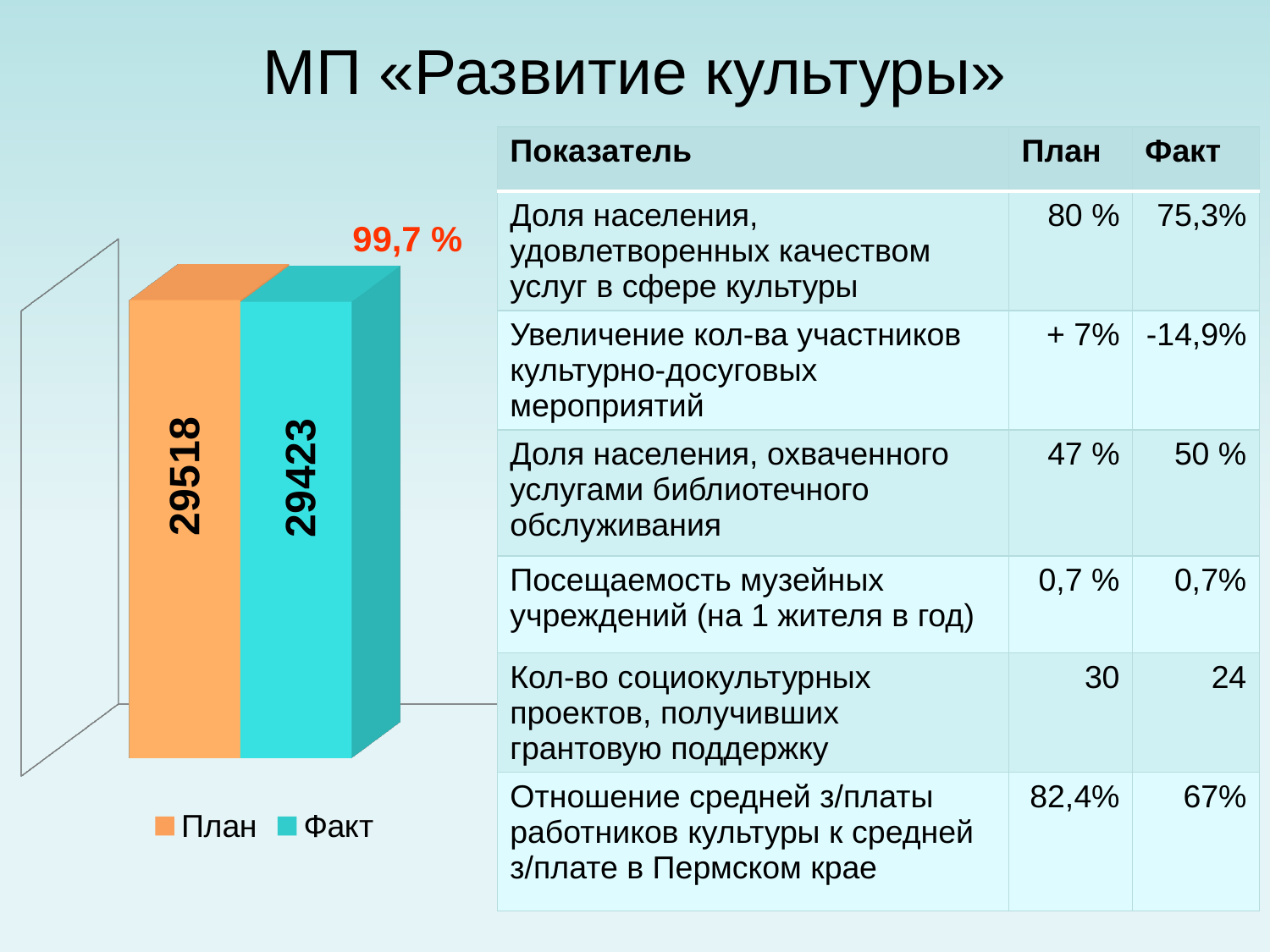
What colour is the Факт bar in the chart? Turquoise How many bars are plotted in the chart? 2 What is the value of the Факт bar in the chart? 29423 Which series has the higher value in the chart, План or Факт? План How many series does the chart legend list? 2 What percentage is printed above the bars in the chart? 99,7 % What is the value of the План bar in the chart? 29518 What is the difference between the План and Факт values in the chart? 95 What kind of chart is shown on the slide? Bar chart Which series has the lowest value in the chart? Факт